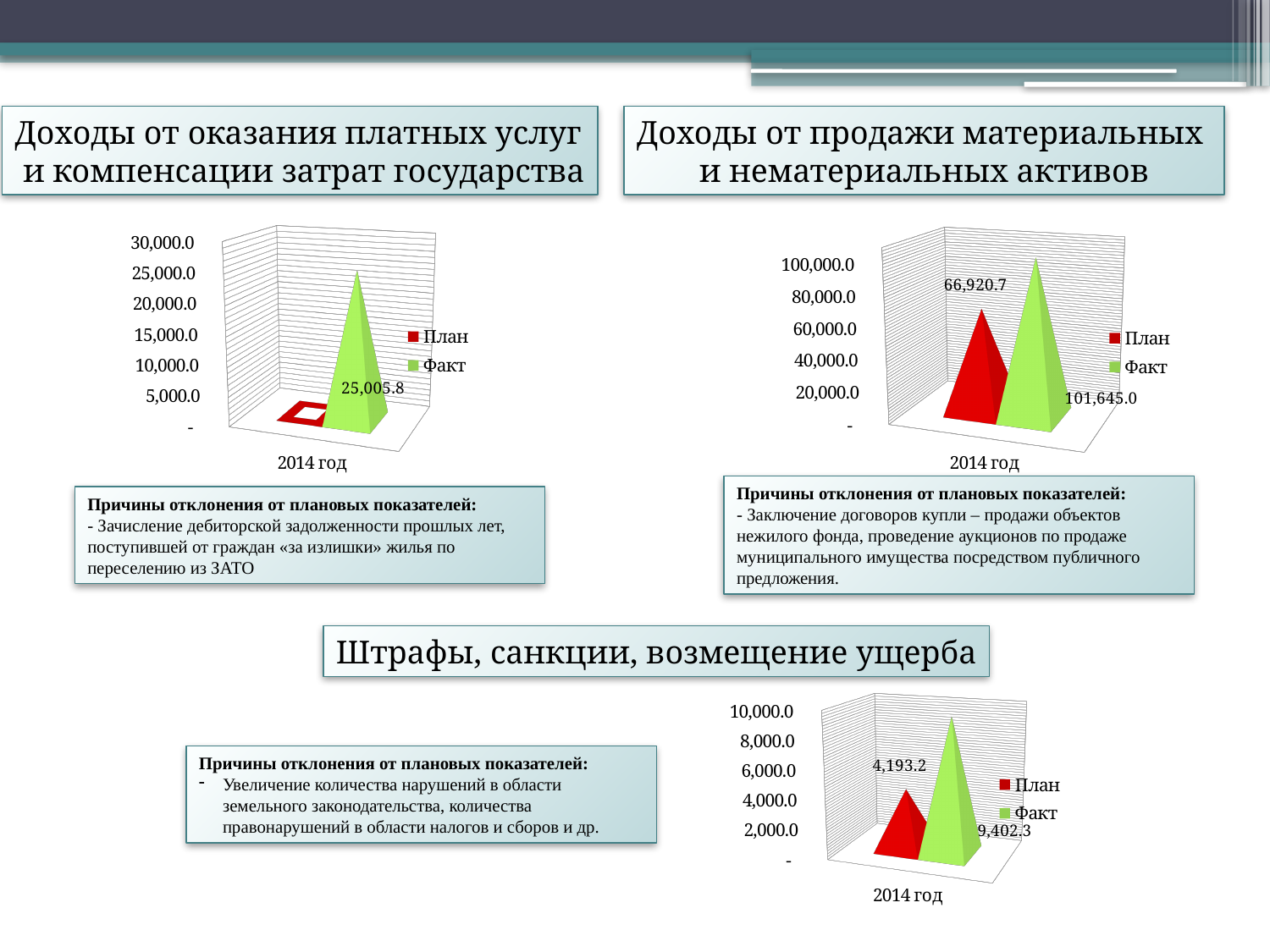
In the chart titled "Штрафы, санкции, возмещение ущерба", what is the value for Факт? 9,402.3 What colour represents the Факт series in the chart titled "Штрафы, санкции, возмещение ущерба"? Green In the chart titled "Доходы от оказания платных услуг и компенсации затрат государства", what is the value for Факт? 25,005.8 In the chart titled "Доходы от продажи материальных и нематериальных активов", what is the value for План? 66,920.7 In the chart titled "Доходы от оказания платных услуг и компенсации затрат государства", is the value for План greater or less than 5,000.0? less In the chart titled "Доходы от продажи материальных и нематериальных активов", what is the value for Факт? 101,645.0 In the chart titled "Доходы от оказания платных услуг и компенсации затрат государства", which series is larger, План or Факт? Факт How many series does the legend list in the chart titled "Штрафы, санкции, возмещение ущерба"? 2 In the chart titled "Доходы от продажи материальных и нематериальных активов", what is the difference between Факт and План? 34,724.3 In the chart titled "Штрафы, санкции, возмещение ущерба", what is the value for План? 4,193.2 In the chart titled "Штрафы, санкции, возмещение ущерба", what is the difference between Факт and План? 5,209.1 How many categories are shown on the x axis of the chart titled "Доходы от продажи материальных и нематериальных активов"? 1